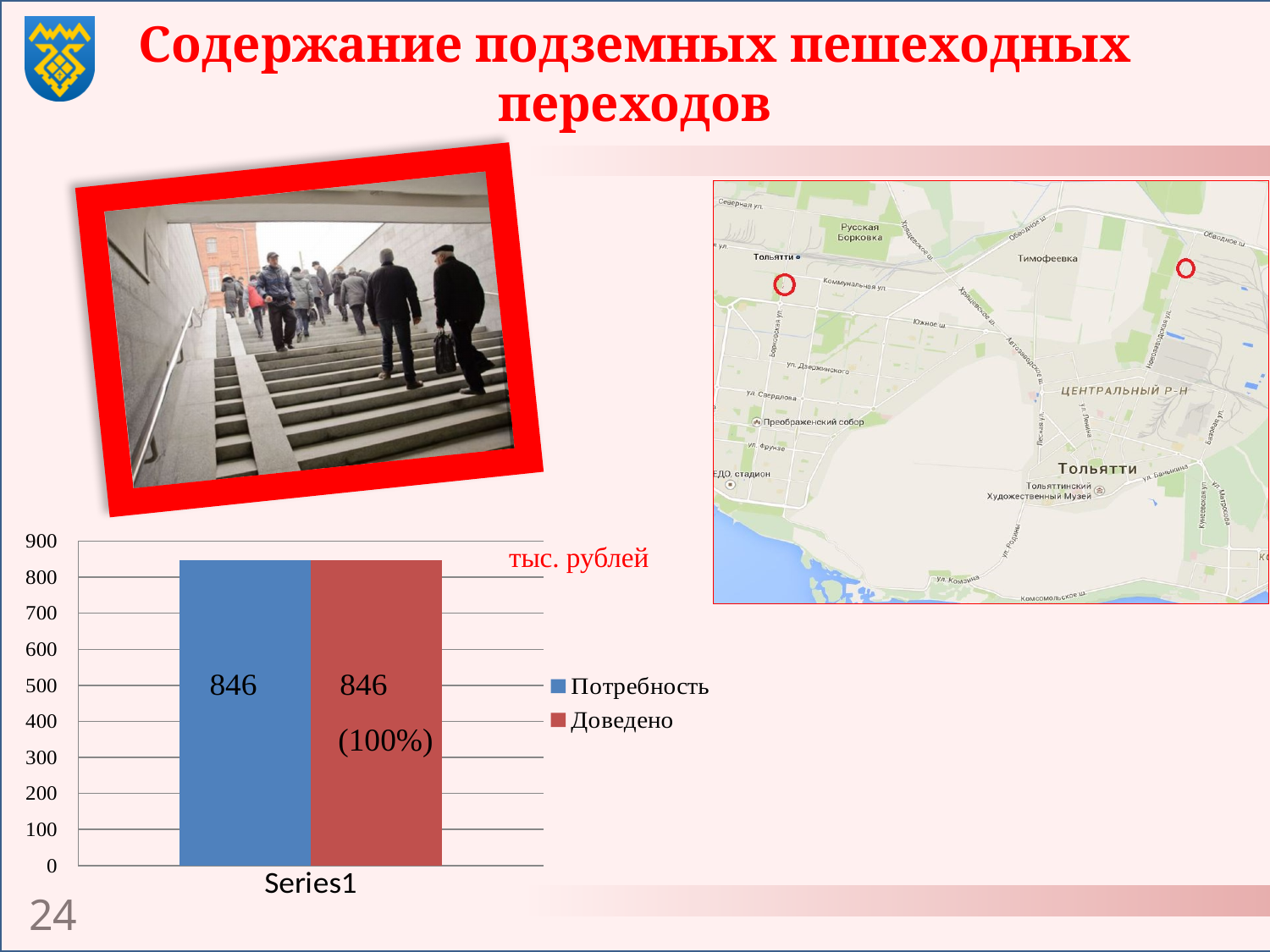
What is the category label on the x axis of the chart? Series1 What kind of chart is shown on the slide? bar chart What is the maximum value shown on the y axis of the chart? 900 Is the value for Потребность greater or less than 800? greater How many series does the legend list? 2 Is the value for Доведено greater or less than 900? less What is the difference between the values for Потребность and Доведено? 0 What is the value for Потребность? 846 What percentage is shown in the data label for Доведено? 100% How many categories are shown on the x axis of the chart? 1 What unit is indicated next to the chart? тыс. рублей What is the value for Доведено? 846